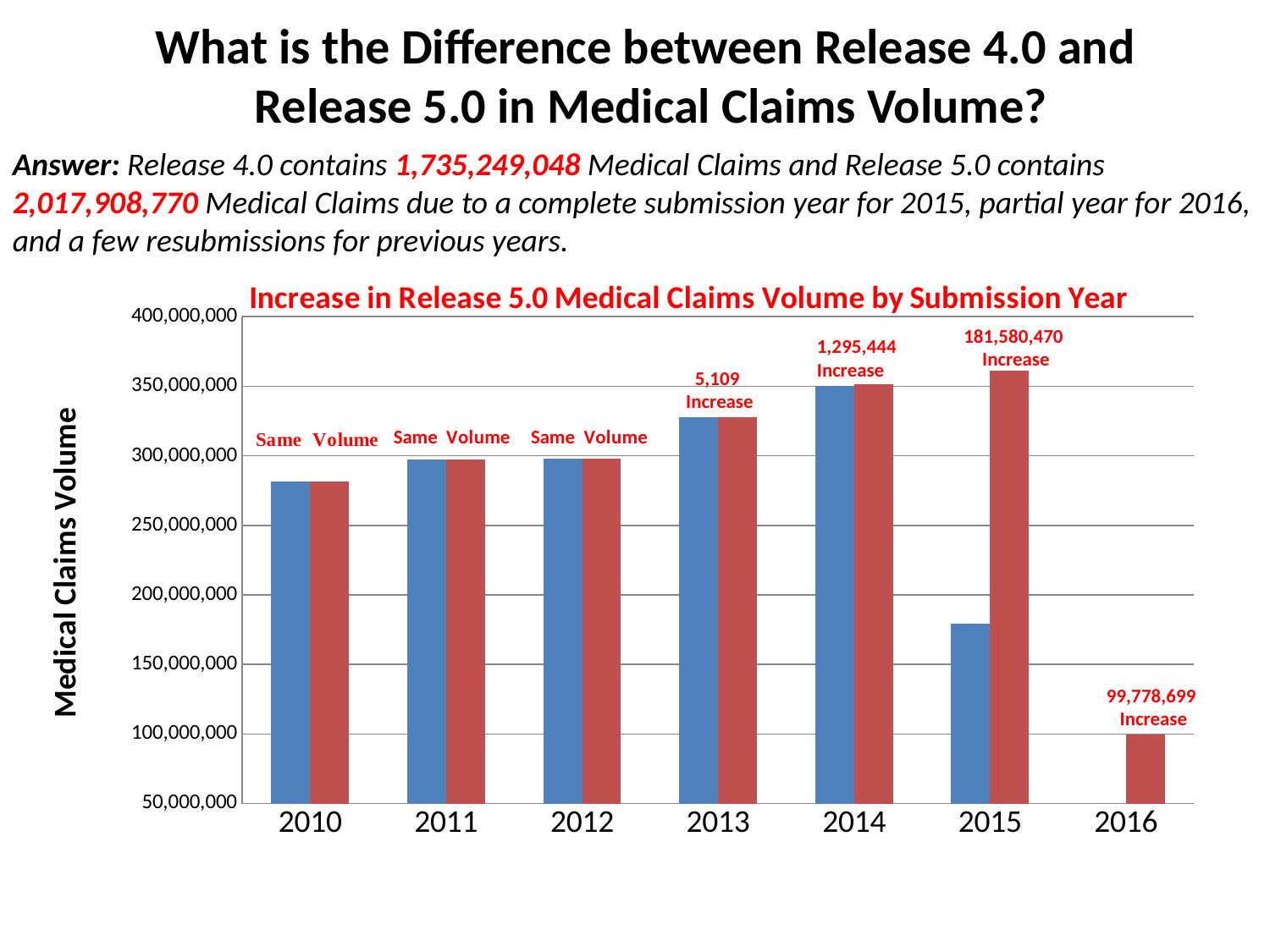
What is the title of the chart? Increase in Release 5.0 Medical Claims Volume by Submission Year Is the value of the blue bar for 2015 greater or less than 200,000,000? less Is the value of the red bar for 2015 greater or less than 350,000,000? greater Is the value of the bars for 2010 greater or less than 300,000,000? less Which submission year has the tallest bar in the chart? 2015 What increase in medical claims volume is labelled for submission year 2016? 99,778,699 Increase What increase in medical claims volume is labelled for submission year 2013? 5,109 Increase What label is shown above the bars for 2010, 2011 and 2012? Same Volume How many submission years are shown on the x axis of the chart? 7 What kind of chart is shown on the slide? bar chart What increase in medical claims volume is labelled for submission year 2015? 181,580,470 Increase What increase in medical claims volume is labelled for submission year 2014? 1,295,444 Increase